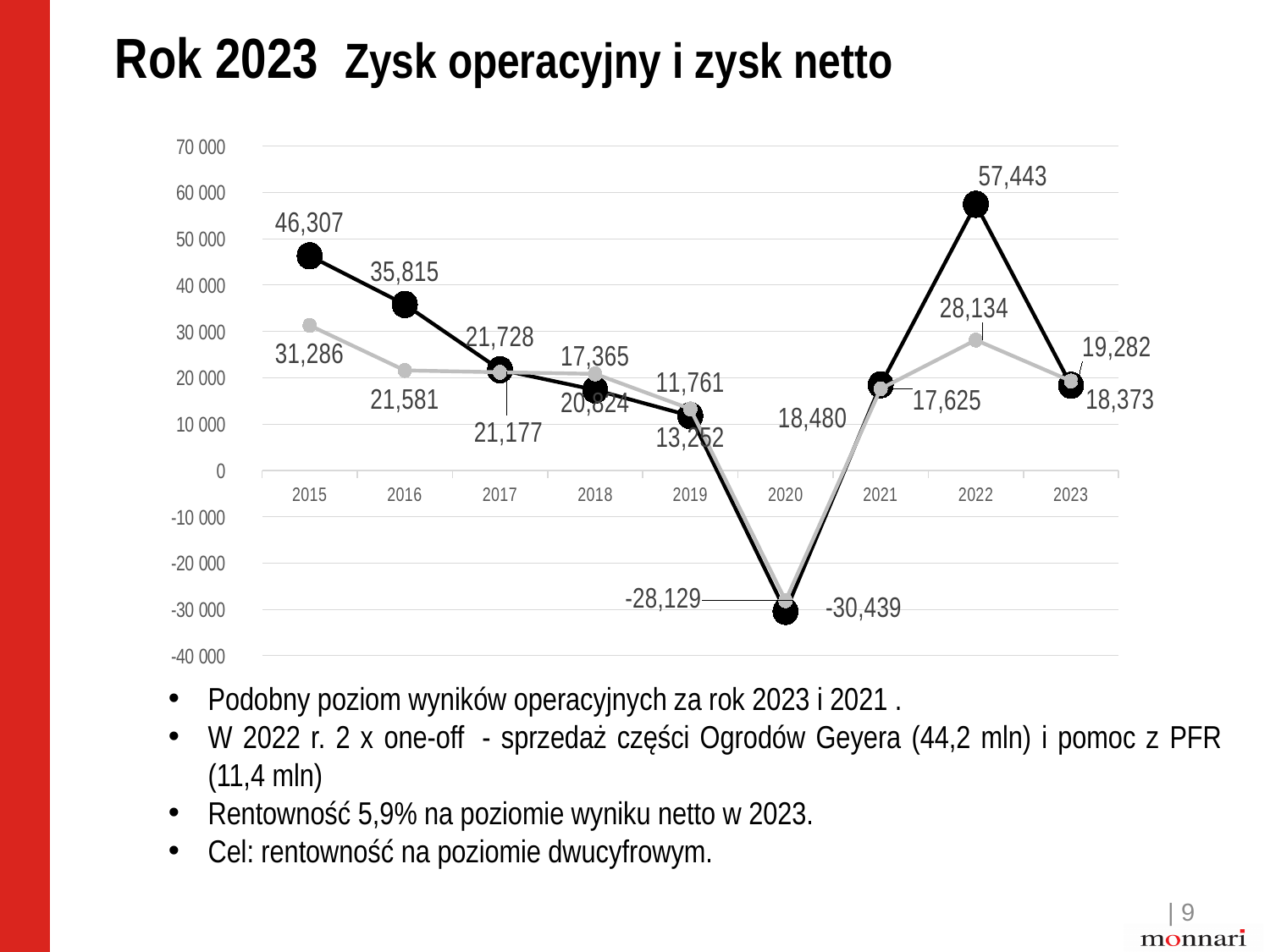
What is the value of the grey line in 2015? 31,286 What is the value of the black line in 2016? 35,815 In which year does the black line reach its highest value? 2022 How many years are shown on the x axis of the chart? 9 What kind of chart is shown on the slide? line chart What is the value of the black line in 2022? 57,443 What is the value of the grey line in 2022? 28,134 What is the value of the black line in 2015? 46,307 Does the black line rise or fall from 2015 to 2019? fall What is the difference between the black line and the grey line in 2022? 29,309 In which year does the black line reach its lowest value? 2020 How many lines are plotted on the chart? 2